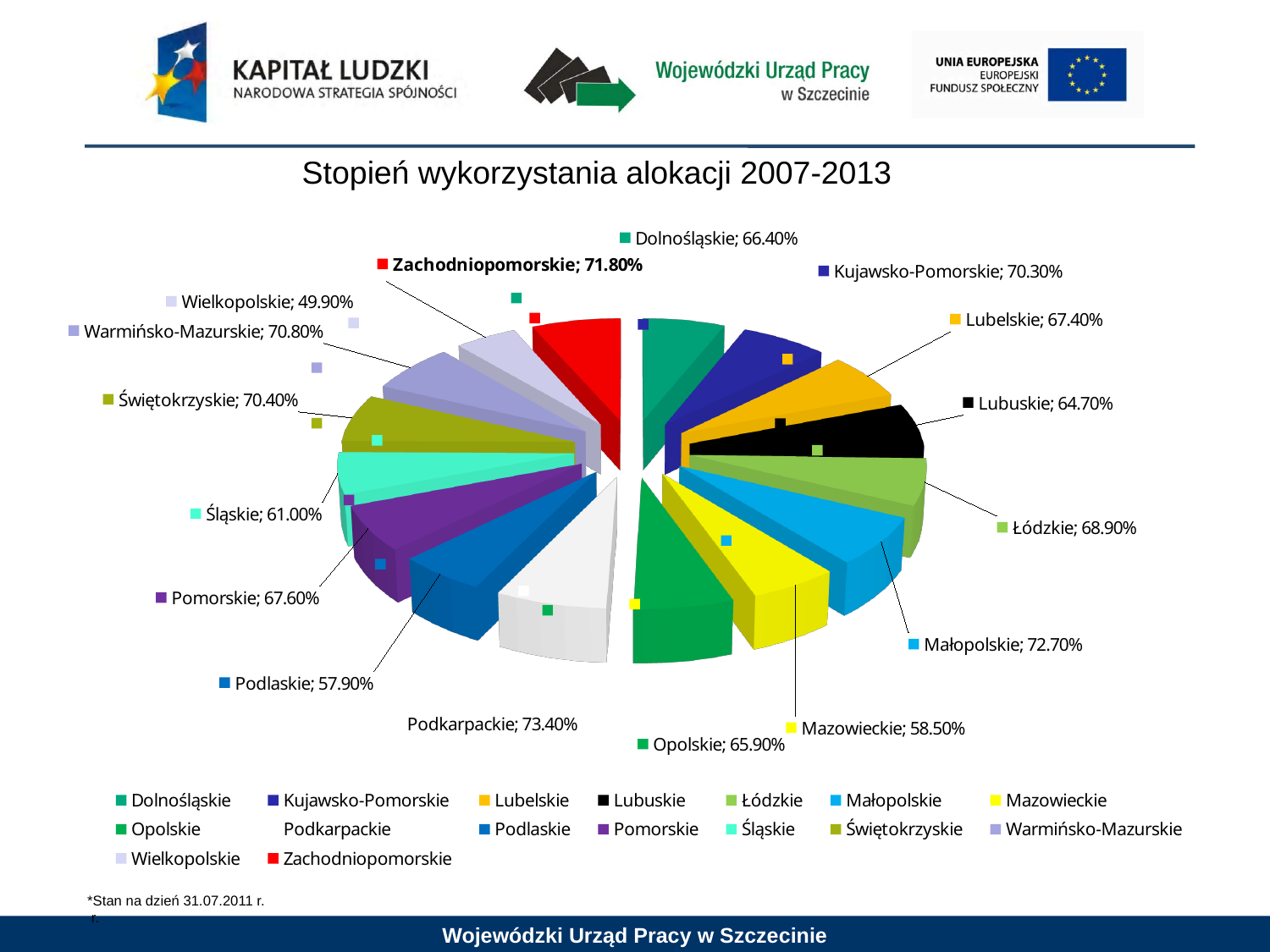
What type of chart is shown on the slide? Pie chart What is the difference between the values for Zachodniopomorskie and Podlaskie? 13.90 percentage points Which region has the highest value in the chart? Podkarpackie How many regions are shown in the pie chart? 16 What is the value shown for Mazowieckie? 58.50% Which has a larger value, Lubelskie or Lubuskie? Lubelskie What is the value shown for Małopolskie? 72.70% What is the value shown for Zachodniopomorskie? 71.80% What is the difference between the values for Podkarpackie and Wielkopolskie? 23.50 percentage points What is the value shown for Wielkopolskie? 49.90% What is the title of the chart? Stopień wykorzystania alokacji 2007-2013 Which region has the lowest value in the chart? Wielkopolskie